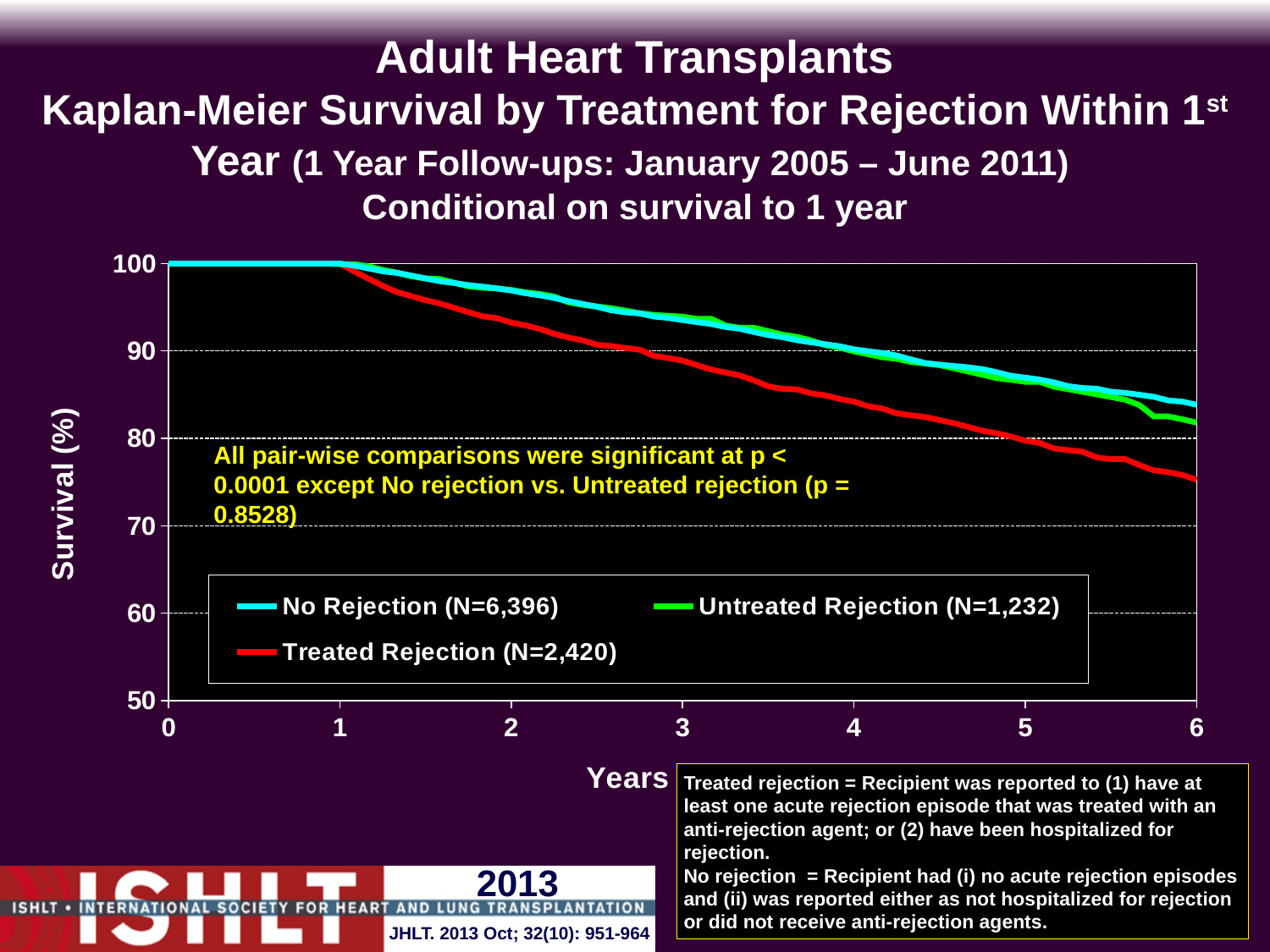
At year 6, which series has higher survival: No Rejection or Treated Rejection? No Rejection At year 4, which series has lower survival: Untreated Rejection or Treated Rejection? Treated Rejection Is the survival value for No Rejection at year 6 greater or less than 80? greater What kind of chart is shown on the slide? Line chart Do the survival curves rise or fall as the years increase? Fall Is the survival value for Treated Rejection at year 2 greater or less than 90? greater How many series does the legend list? 3 Which series has the lowest survival at year 6? Treated Rejection What is the N shown in the legend for the No Rejection series? N=6,396 Is the survival value for Treated Rejection at year 6 greater or less than 80? less According to the annotation on the chart, what is the p-value for No rejection vs. Untreated rejection? 0.8528